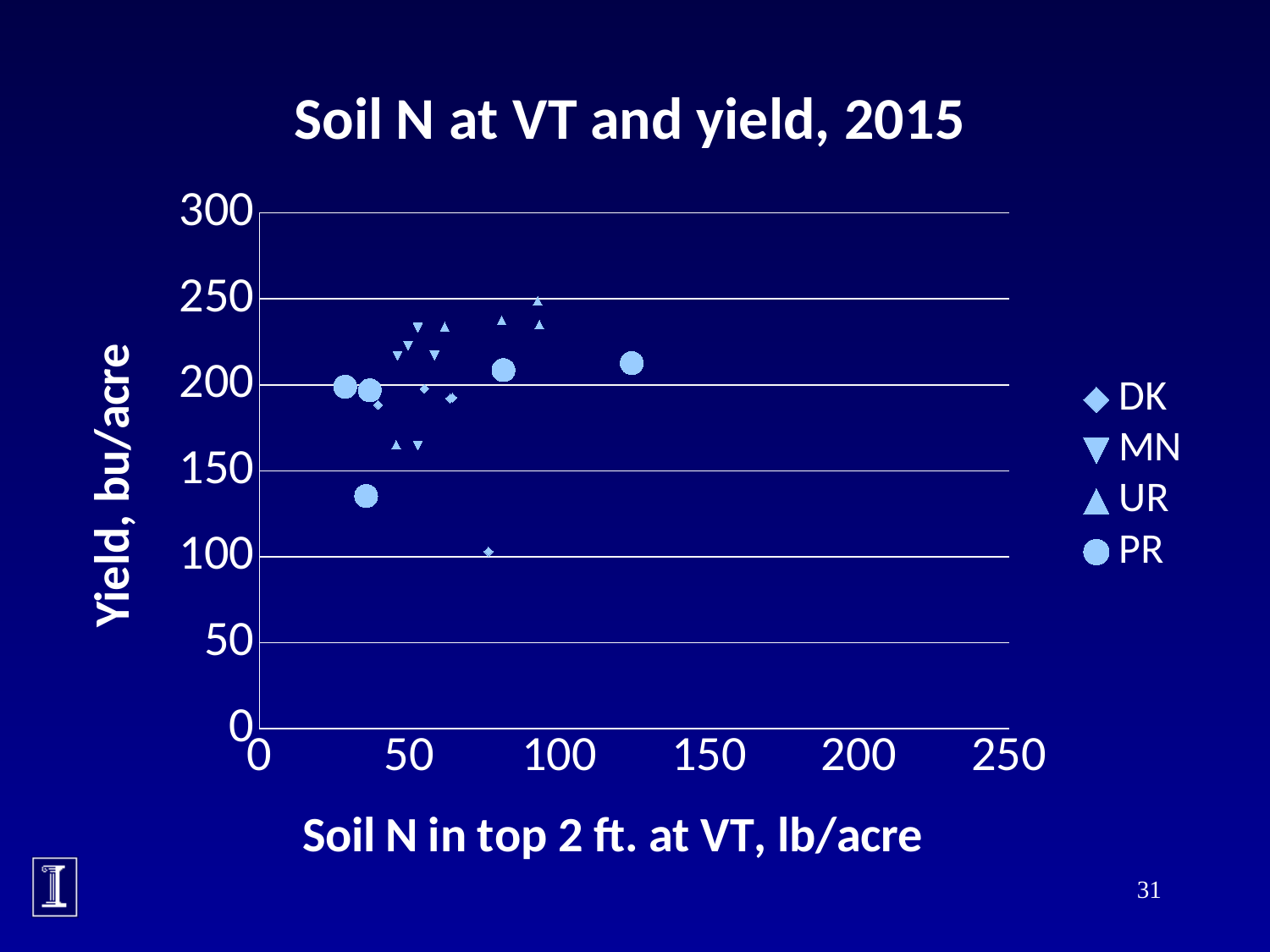
What is the title of the chart? Soil N at VT and yield, 2015 Which series has the point with the highest soil N value? PR How many series does the legend list? 4 Which series has the point with the lowest yield? DK Is the yield of the PR point with the highest soil N greater or less than 200? greater What is the label of the y axis? Yield, bu/acre Is the yield of the highest UR point greater or less than 200? greater Is the yield of the lowest DK point greater or less than 150? less Which series has the point with the highest yield? UR What kind of chart is shown on the slide? Scatter chart How many PR points are plotted? 5